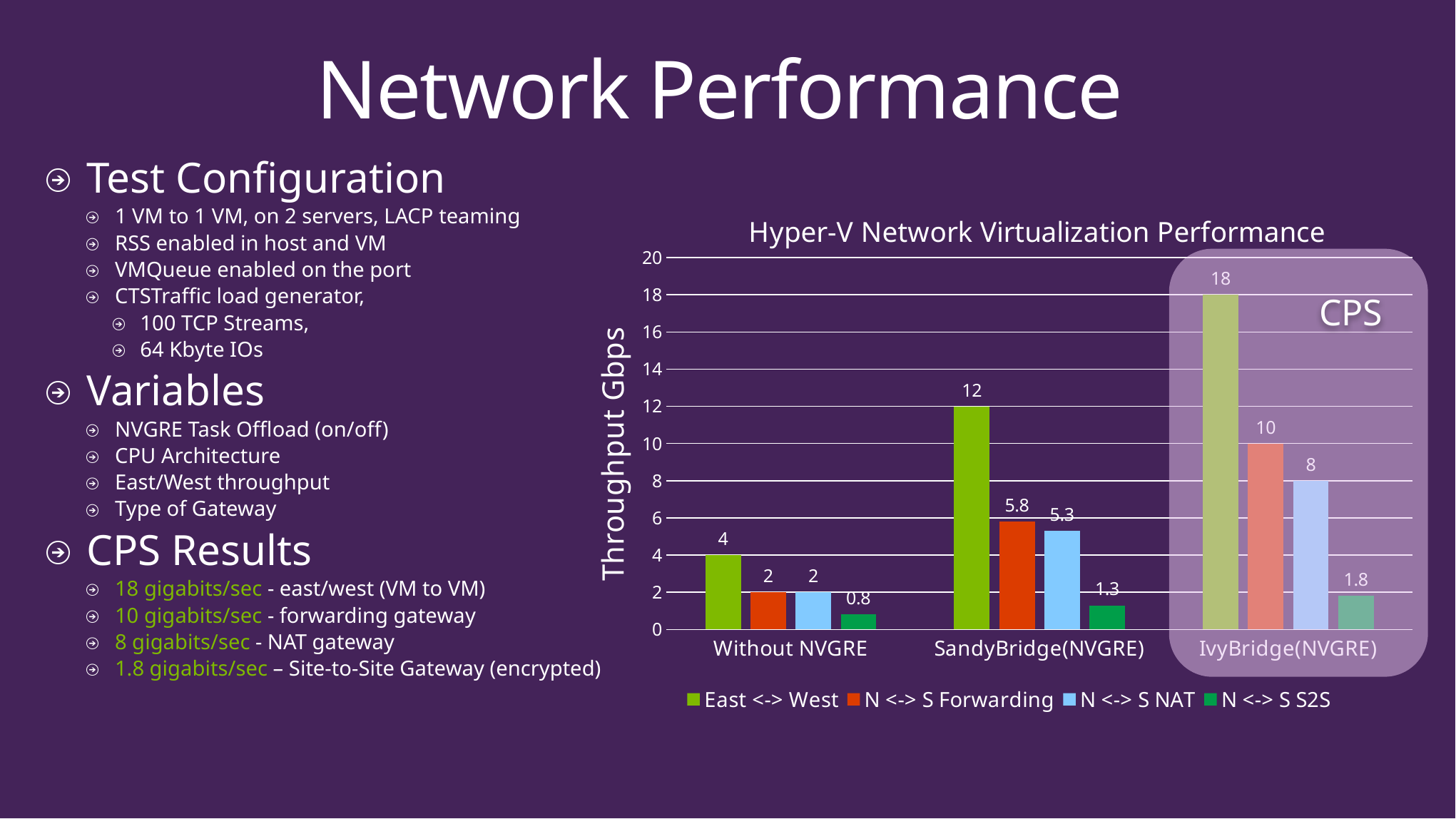
What is the title of the chart? Hyper-V Network Virtualization Performance What is the East <-> West throughput for IvyBridge(NVGRE)? 18 How many categories are shown on the x axis? 3 How many series does the legend list? 4 What is the difference between the East <-> West values for IvyBridge(NVGRE) and SandyBridge(NVGRE)? 6 What is the N <-> S S2S value for Without NVGRE? 0.8 What kind of chart is shown? bar chart Which is larger: N <-> S Forwarding for SandyBridge(NVGRE) or N <-> S Forwarding for IvyBridge(NVGRE)? IvyBridge(NVGRE) What is the N <-> S NAT value for SandyBridge(NVGRE)? 5.3 Does the East <-> West throughput rise or fall from Without NVGRE to IvyBridge(NVGRE)? rise Which category has the highest East <-> West throughput? IvyBridge(NVGRE) Which series has the lowest value for SandyBridge(NVGRE)? N <-> S S2S